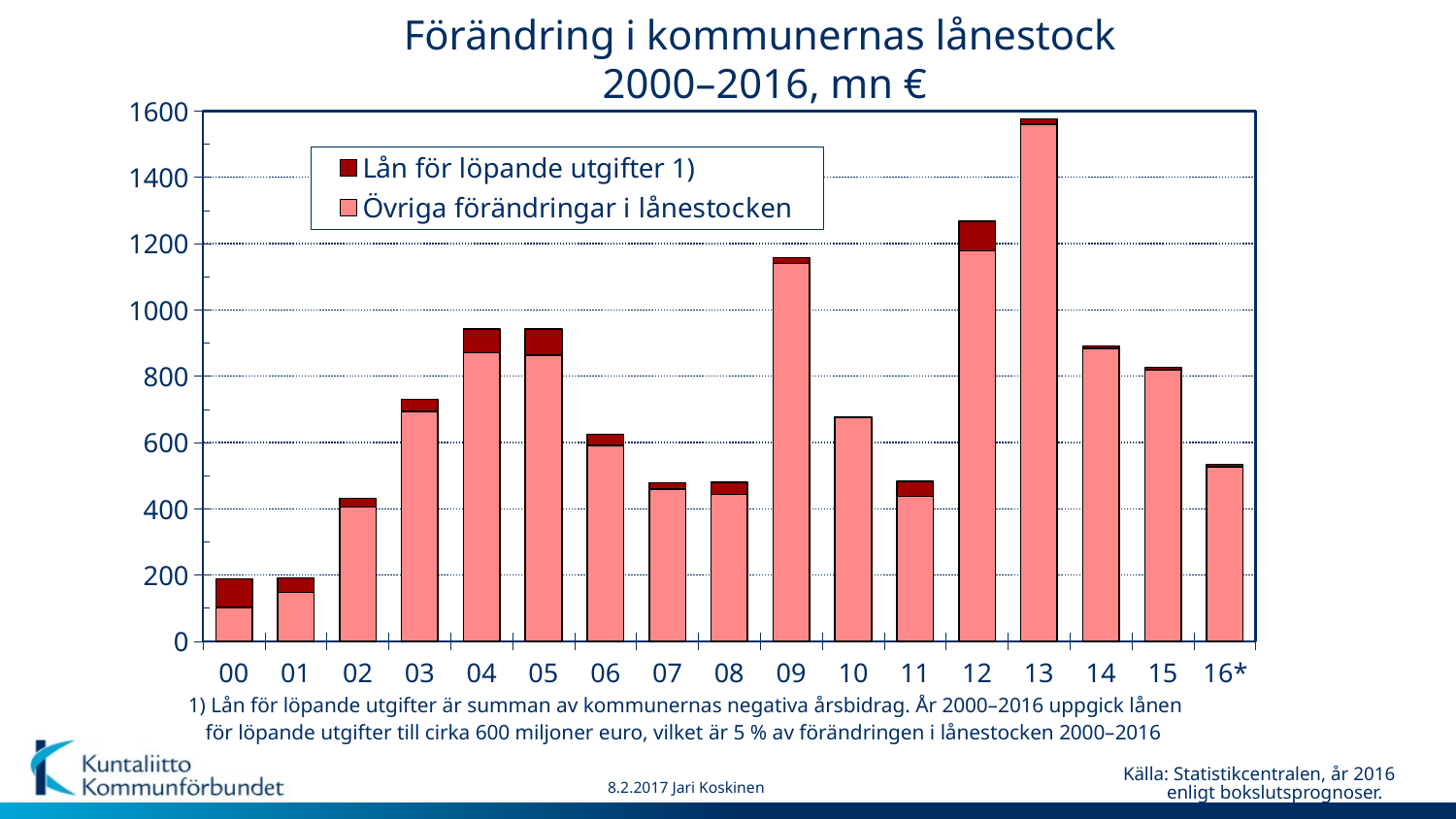
What is the title of the chart? Förändring i kommunernas lånestock 2000–2016, mn € Is the total value for year 09 greater or less than 1000? greater Is the total value for year 14 greater or less than 1000? less How many years (categories) are shown on the x axis? 17 Do the total values rise or fall from year 13 to year 16*? fall Is the total value for year 13 greater or less than 1400? greater Which year has the larger total bar, 09 or 12? 12 What kind of chart is shown on the slide? Stacked bar chart Which year has the highest total change in the loan stock? 13 How many series does the legend list? 2